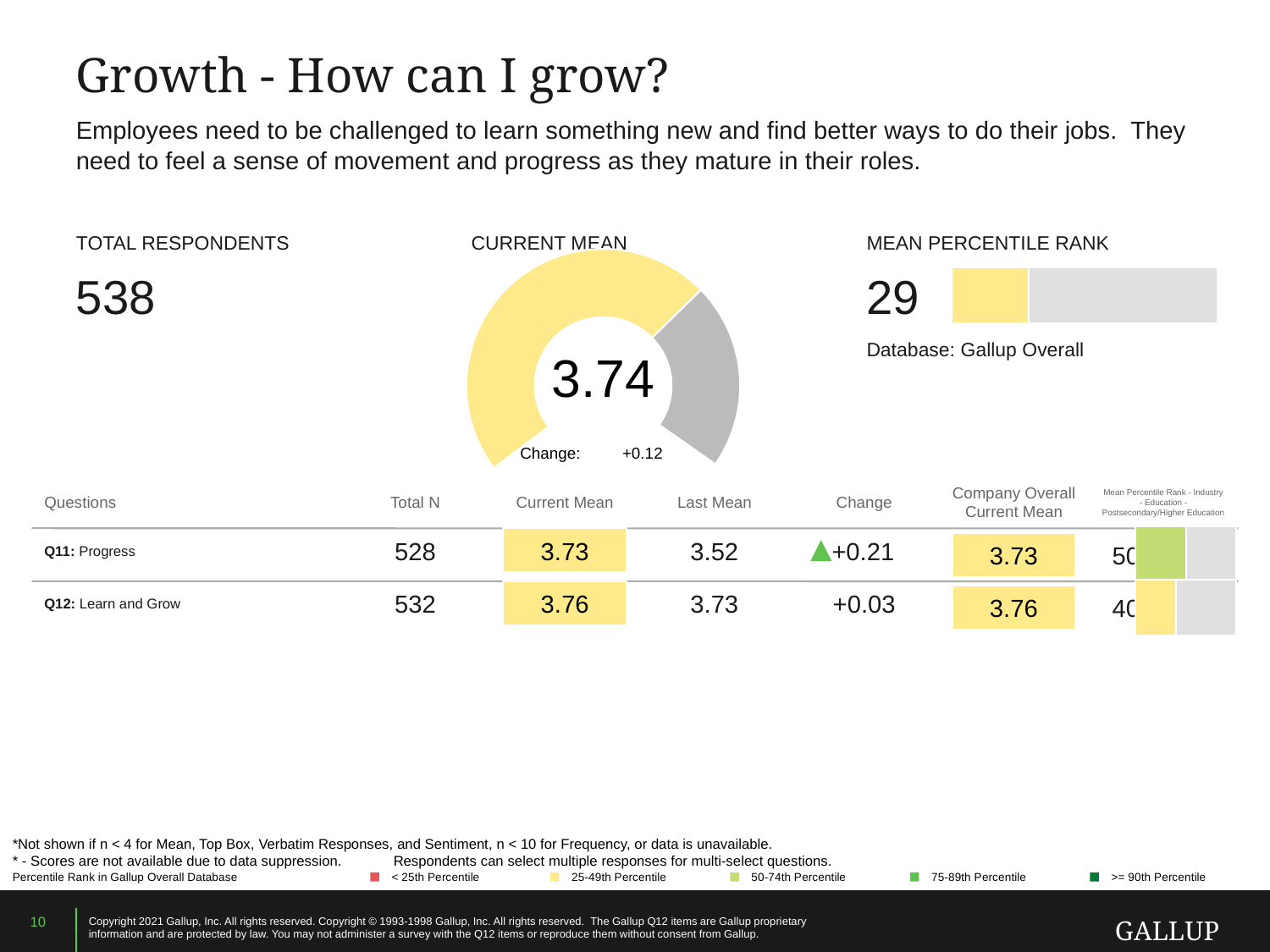
What is the Last Mean for Q12: Learn and Grow? 3.73 What value does the Current Mean gauge chart display? 3.74 What kind of chart is used to show the Current Mean of 3.74? gauge chart What is the Total N for Q12: Learn and Grow? 532 What is the Mean Percentile Rank value shown next to the percentile bar? 29 What is the Current Mean for Q11: Progress in the table? 3.73 Which database is the Mean Percentile Rank compared against? Gallup Overall Which question has the higher Current Mean, Q11: Progress or Q12: Learn and Grow? Q12: Learn and Grow How many questions are listed in the table? 2 What is the difference between the Current Mean and Last Mean for Q11: Progress? 0.21 What change is shown beneath the Current Mean gauge? +0.12 What is the Change value for Q11: Progress? +0.21